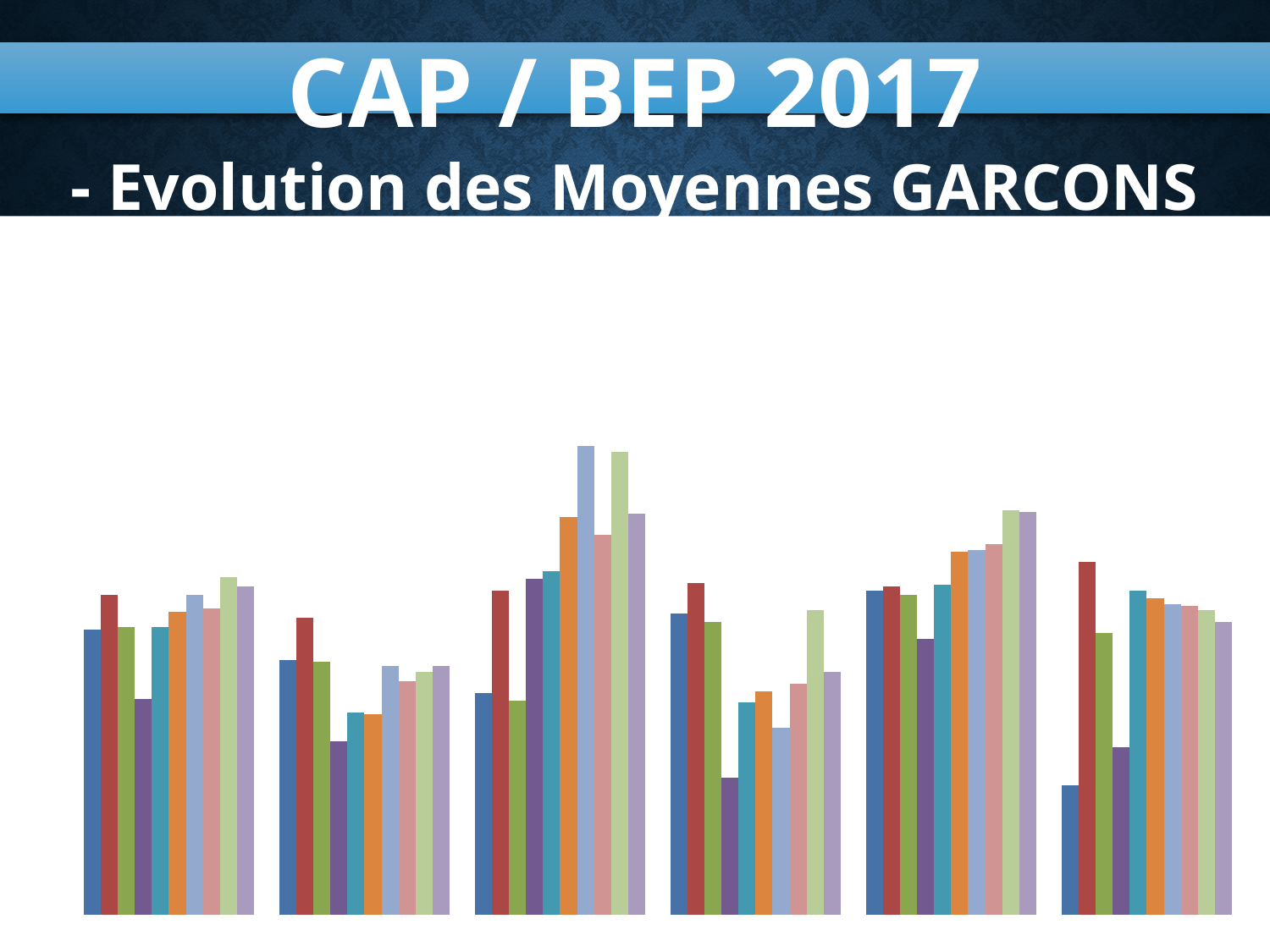
In the sixth group from the left, is the first (dark blue) bar taller or shorter than the second (red) bar? shorter In the first group from the left, is the first (dark blue) bar taller or shorter than the fourth (purple) bar? taller What kind of chart is shown on the slide? bar chart How many groups of bars does the chart contain? 6 Does the chart display a legend? No How many bars are there in each group of the chart? 10 Which group of bars, counted from the left, contains the tallest bar on the chart? the third group What is the title shown at the top of the slide? CAP / BEP 2017 - Evolution des Moyennes GARCONS